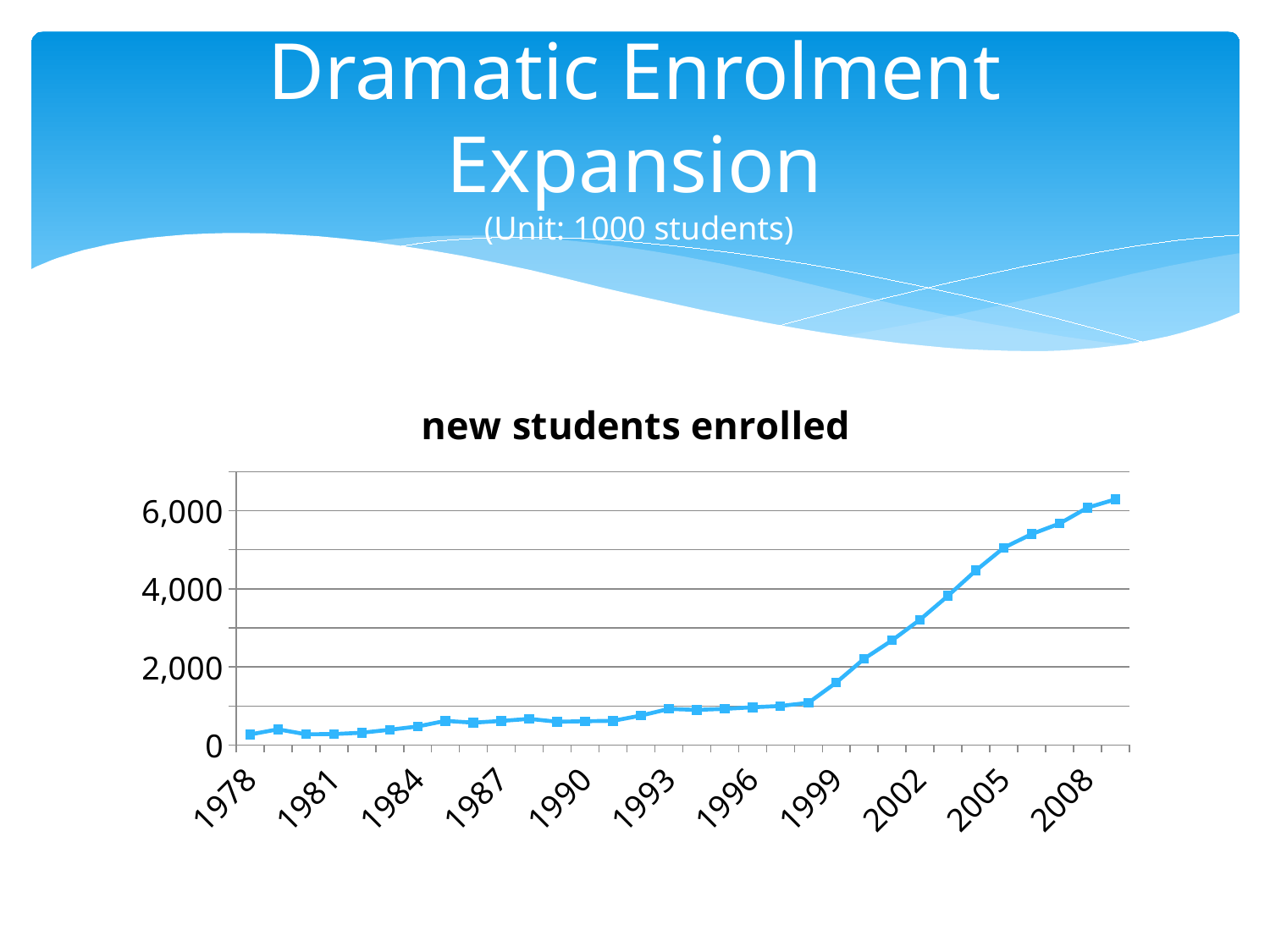
Is the value for 1999 greater or less than 2,000? less What is the title of the chart? new students enrolled Is the value for 2002 greater or less than 2,000? greater Which has a larger value, 1984 or 2005? 2005 What unit is stated for the chart values? 1000 students Is the value for 2008 greater or less than 4,000? greater Do the values generally rise or fall from 1978 to the end of the series? rise What kind of chart is shown on the slide? line chart